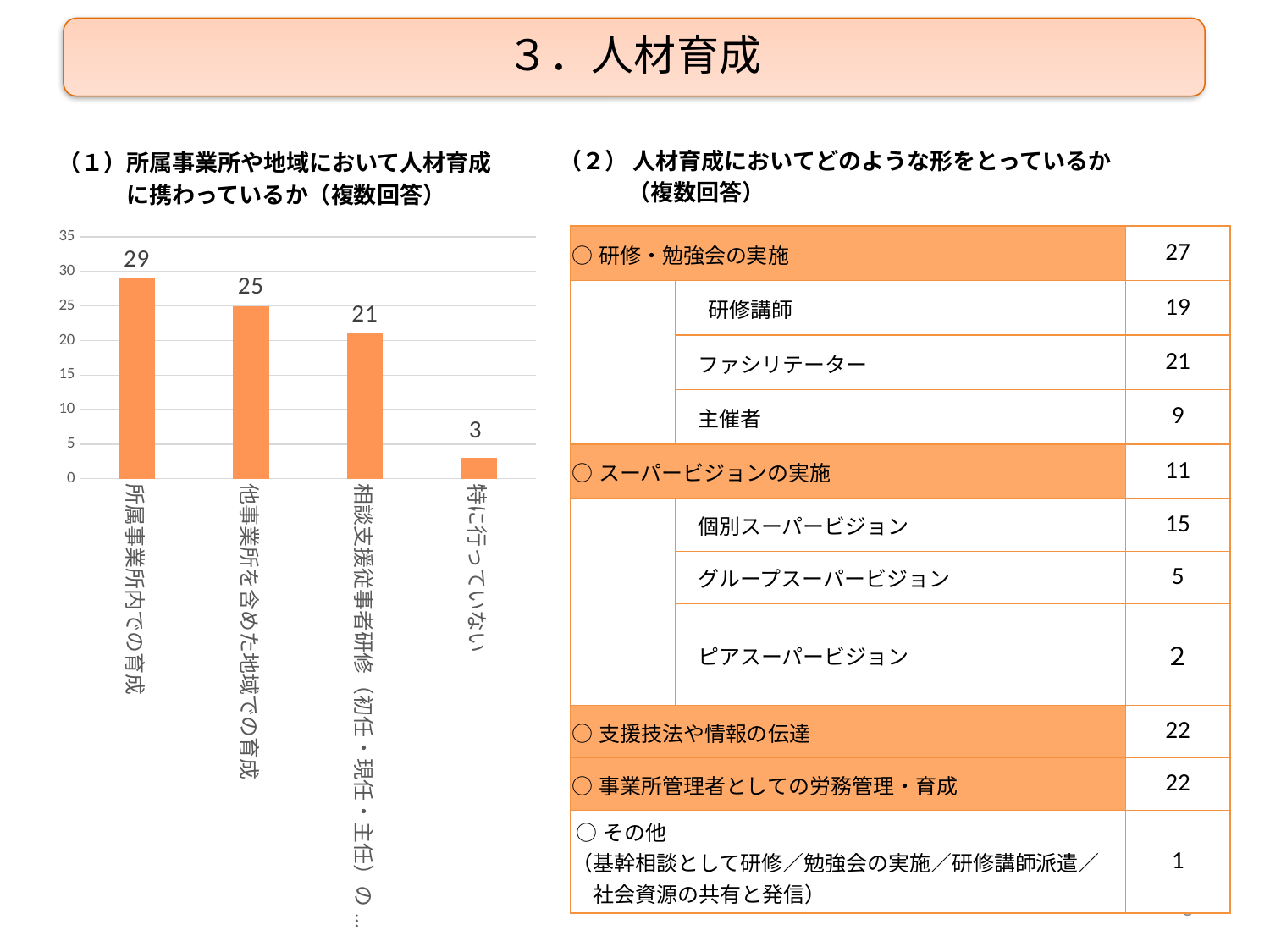
What is the difference between the values for 所属事業所内での育成 and 他事業所を含めた地域での育成 in the bar chart? 4 What kind of chart is shown on the left of the slide? bar chart What is the value for 他事業所を含めた地域での育成 in the bar chart? 25 Which category has the lowest value in the bar chart? 特に行っていない Is the value for 特に行っていない in the bar chart greater or less than 5? less What is the value for 相談支援従事者研修（初任・現任・主任）の… in the bar chart? 21 How many categories are shown in the bar chart? 4 What is the value for 所属事業所内での育成 in the bar chart? 29 Do the values in the bar chart rise or fall from left to right? fall What is the value for 特に行っていない in the bar chart? 3 Which category has the highest value in the bar chart? 所属事業所内での育成 Which is larger in the bar chart: 他事業所を含めた地域での育成 or 相談支援従事者研修（初任・現任・主任）の…? 他事業所を含めた地域での育成